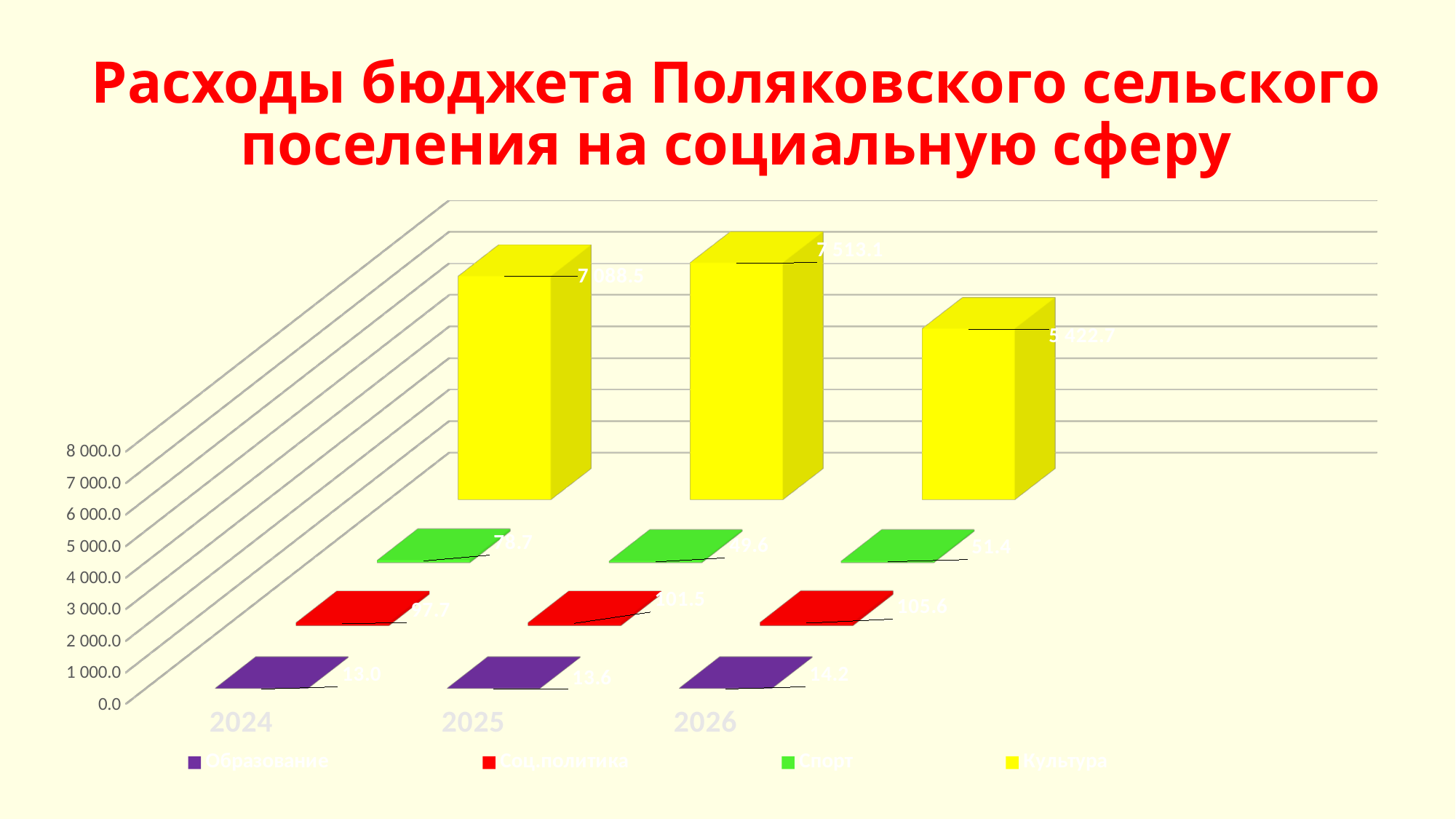
Which year has the lowest value for Культура? 2026 What kind of chart is shown on the slide? bar chart Is the value for Культура in 2024 greater or less than 4 000.0? greater How many years (categories) are shown on the x axis? 3 What is the difference between Культура in 2025 and Культура in 2026? 2 090.4 What is the value for Образование in 2026? 14.2 Which colour represents Культура in the legend? yellow What is the value for Культура in 2025? 7 513.1 Which is larger: Культура in 2025 or Культура in 2026? 2025 How many series does the legend list? 4 What is the value for Культура in 2026? 5 422.7 Which year has the highest value for Культура? 2025